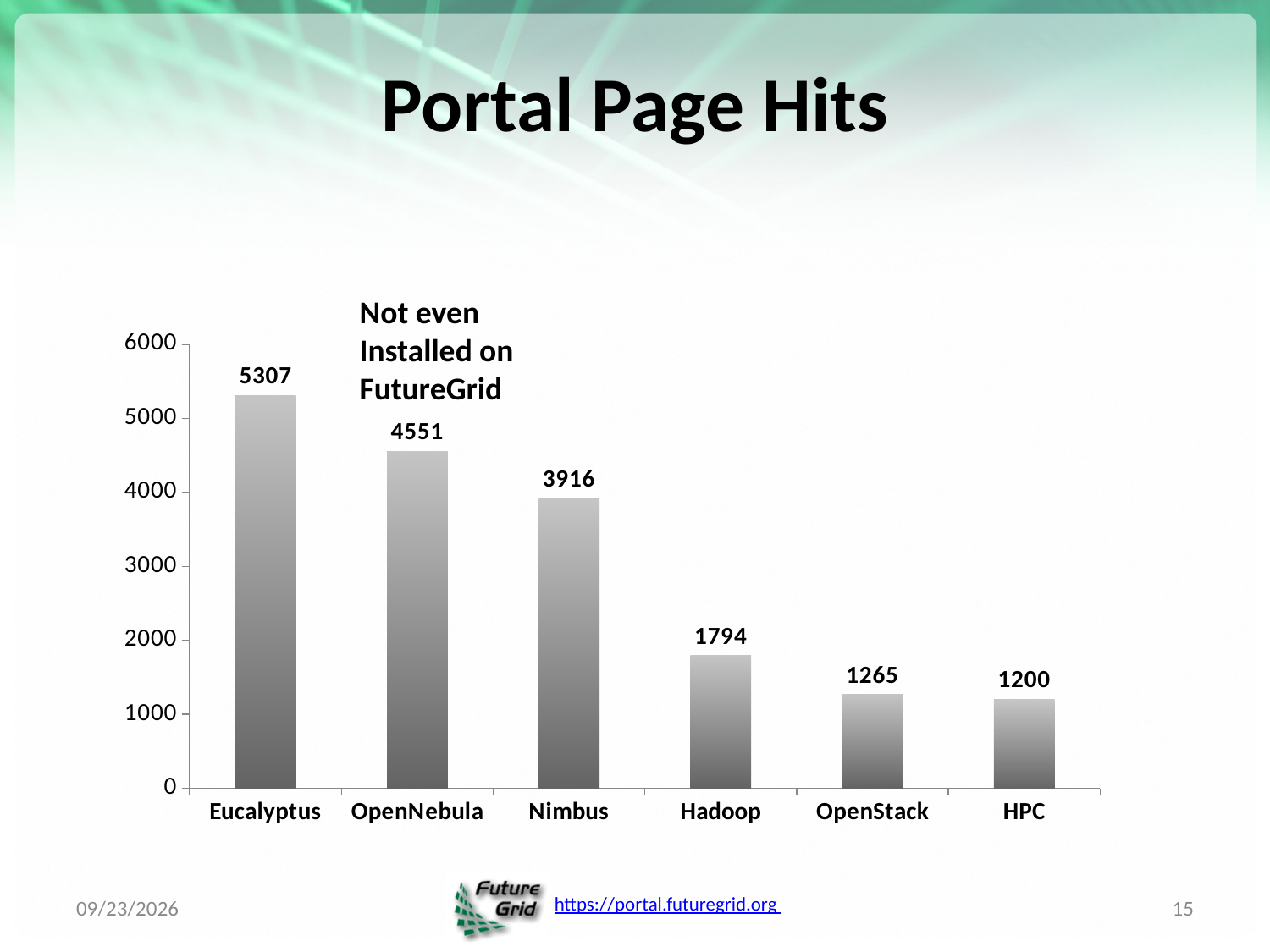
Which is larger, the value for Hadoop or the value for OpenStack? Hadoop Which category has the highest value? Eucalyptus Is the value for Nimbus greater or less than 4000? less What is the difference between the values for Eucalyptus and HPC? 4107 How many categories are shown on the x axis? 6 What is the value for Hadoop? 1794 What kind of chart is shown on the slide? bar chart What is the difference between the values for OpenNebula and Nimbus? 635 What is the value for Eucalyptus? 5307 Do the values rise or fall from left to right along the x axis? fall Which category has the lowest value? HPC What is the value for HPC? 1200